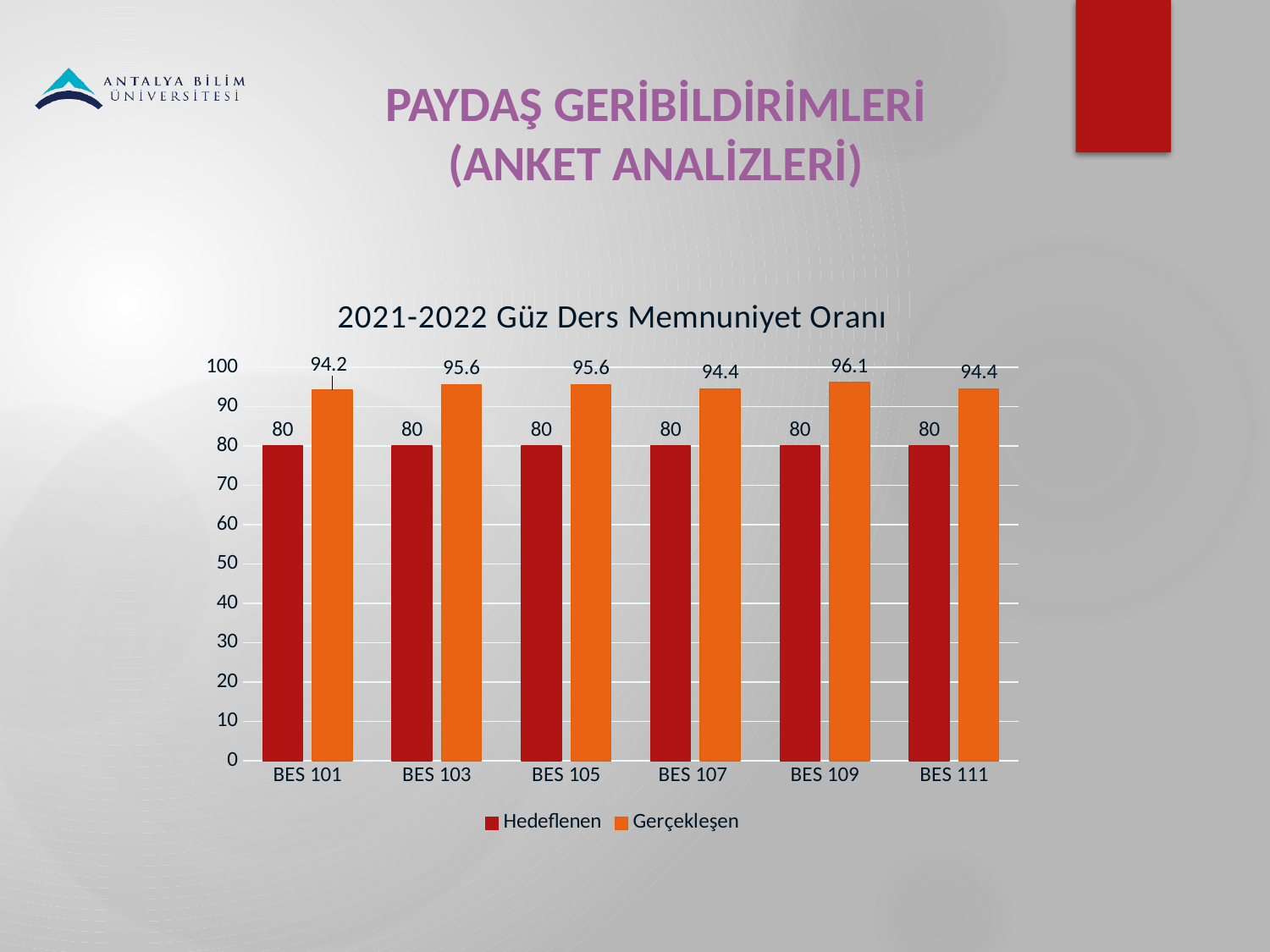
What kind of chart is shown on the slide? Bar chart What is the Gerçekleşen value for BES 109? 96.1 How many courses are shown on the x axis? 6 What is the Hedeflenen value for BES 107? 80 Which is larger: the Gerçekleşen value for BES 105 or for BES 107? BES 105 What is the difference between the Gerçekleşen and Hedeflenen values for BES 103? 15.6 What is the Gerçekleşen value for BES 101? 94.2 Which course has the highest Gerçekleşen value? BES 109 What is the difference between the Gerçekleşen values for BES 109 and BES 111? 1.7 What is the title of the chart? 2021-2022 Güz Ders Memnuniyet Oranı Which course has the lowest Gerçekleşen value? BES 101 How many series does the legend list? 2